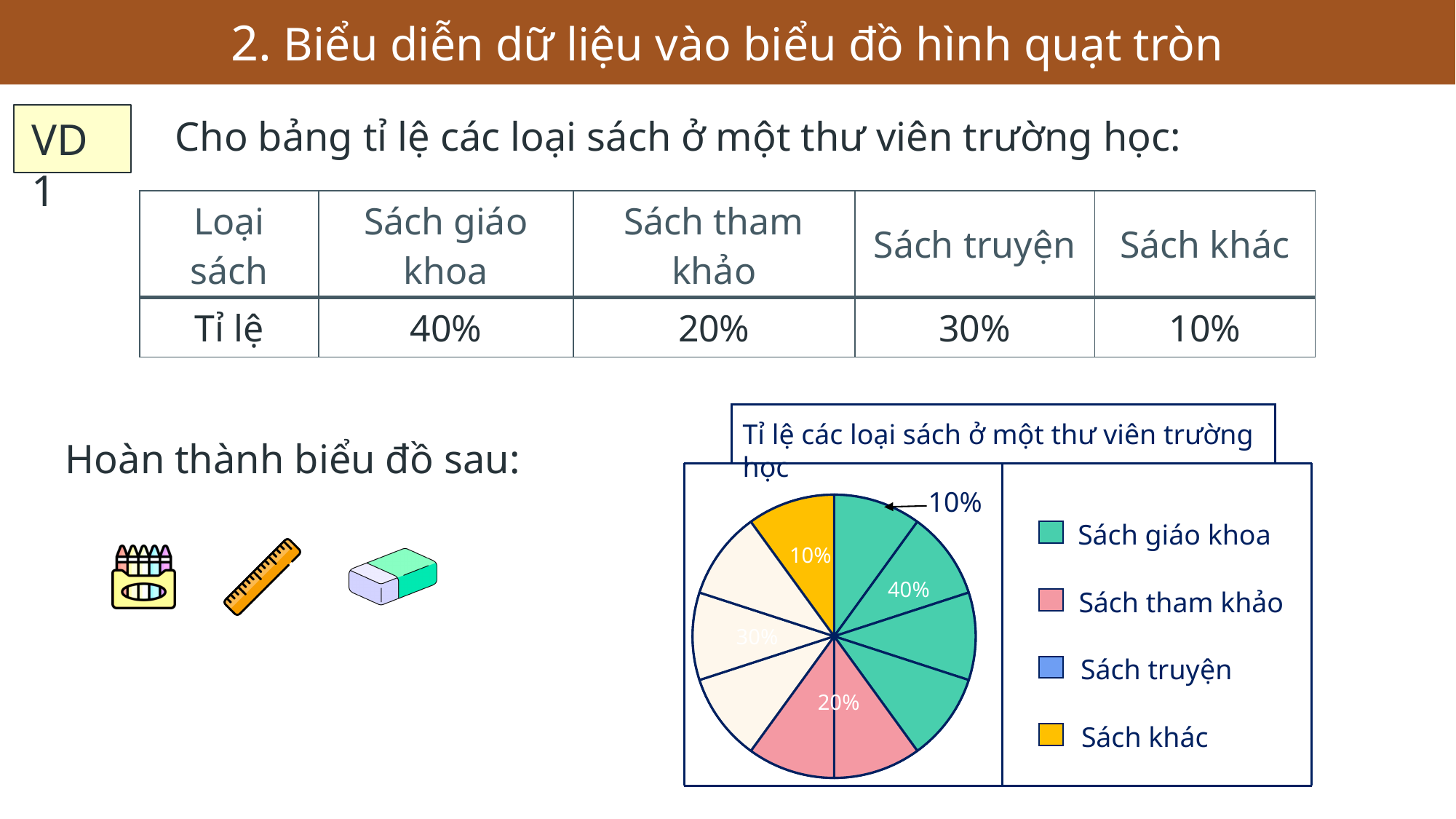
What kind of chart is shown on the slide? pie chart What share of the pie chart does Sách truyện take? 30% What colour does the legend assign to Sách khác in the pie chart? yellow What is the title of the pie chart? Tỉ lệ các loại sách ở một thư viên trường học Which is larger in the pie chart, the share of Sách truyện or the share of Sách tham khảo? Sách truyện Which category has the smallest slice in the pie chart? Sách khác What share of the pie chart does Sách giáo khoa take? 40% What share of the pie chart does Sách tham khảo take? 20% Which category has the largest slice in the pie chart? Sách giáo khoa What is the difference between the shares of Sách giáo khoa and Sách tham khảo in the pie chart? 20% How many entries does the legend of the pie chart list? 4